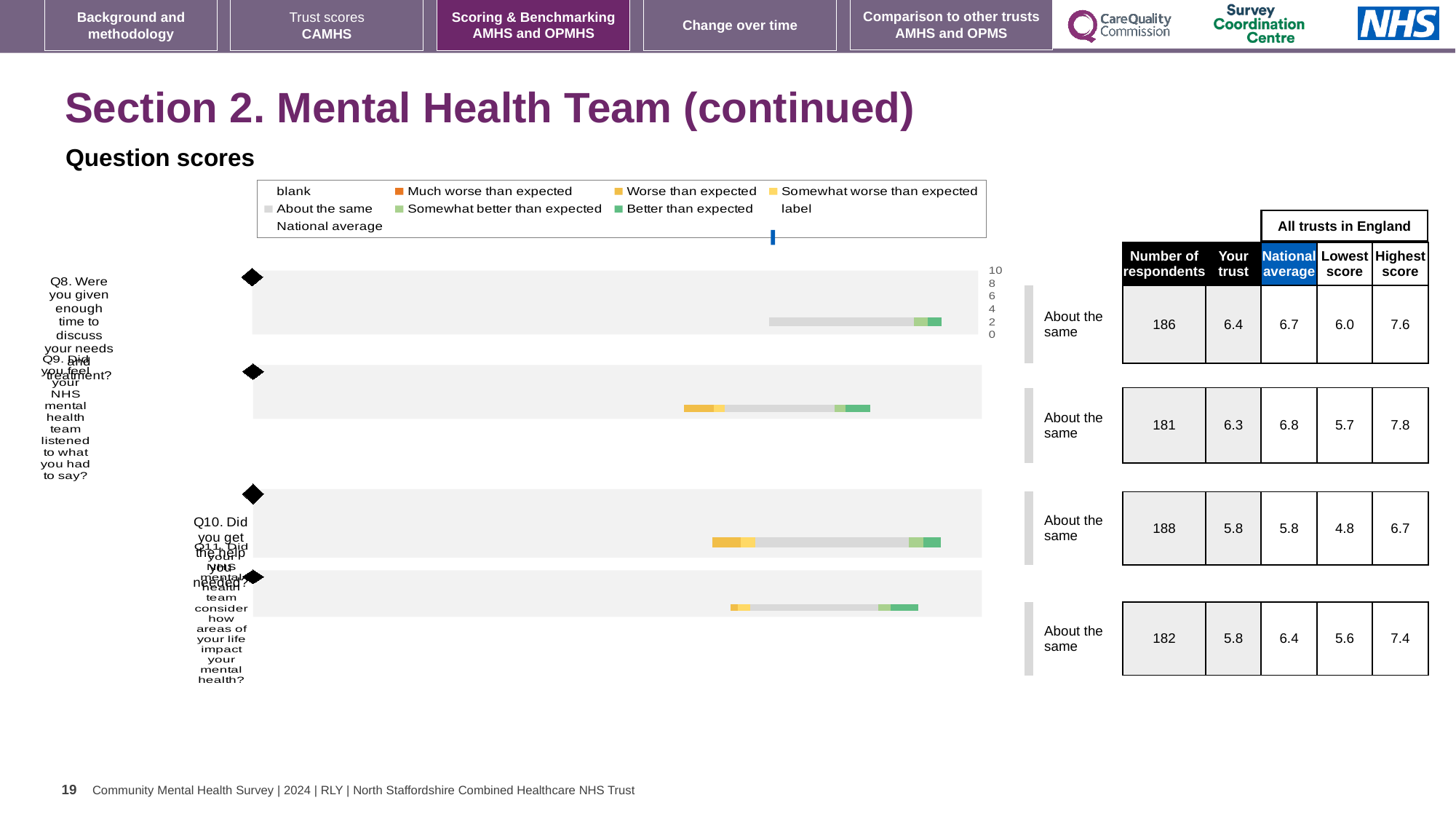
Which has the higher 'Your trust' score, Q8 or Q9? Q8 In the legend, what colour represents 'Much worse than expected'? Orange For Q10 (Did you get the help you needed?), what is the lowest score among all trusts in England? 4.8 For Q9 (Did you feel your NHS mental health team listened to what you had to say?), what is the national average score? 6.8 For Q9, what is the difference between the national average and the 'Your trust' score? 0.5 Which question has the lowest 'Lowest score' value in the table? Q10 In the legend, what colour represents 'Better than expected'? Green What kind of chart is used to show the question scores for Q8 to Q11? Bar chart For Q8 (Were you given enough time to discuss your needs and treatment?), what is the 'Your trust' score in the table? 6.4 How many question charts (Q8 to Q11) are shown on the slide? 4 For Q11, what is the highest score among all trusts in England? 7.4 Which question has the highest number of respondents? Q10